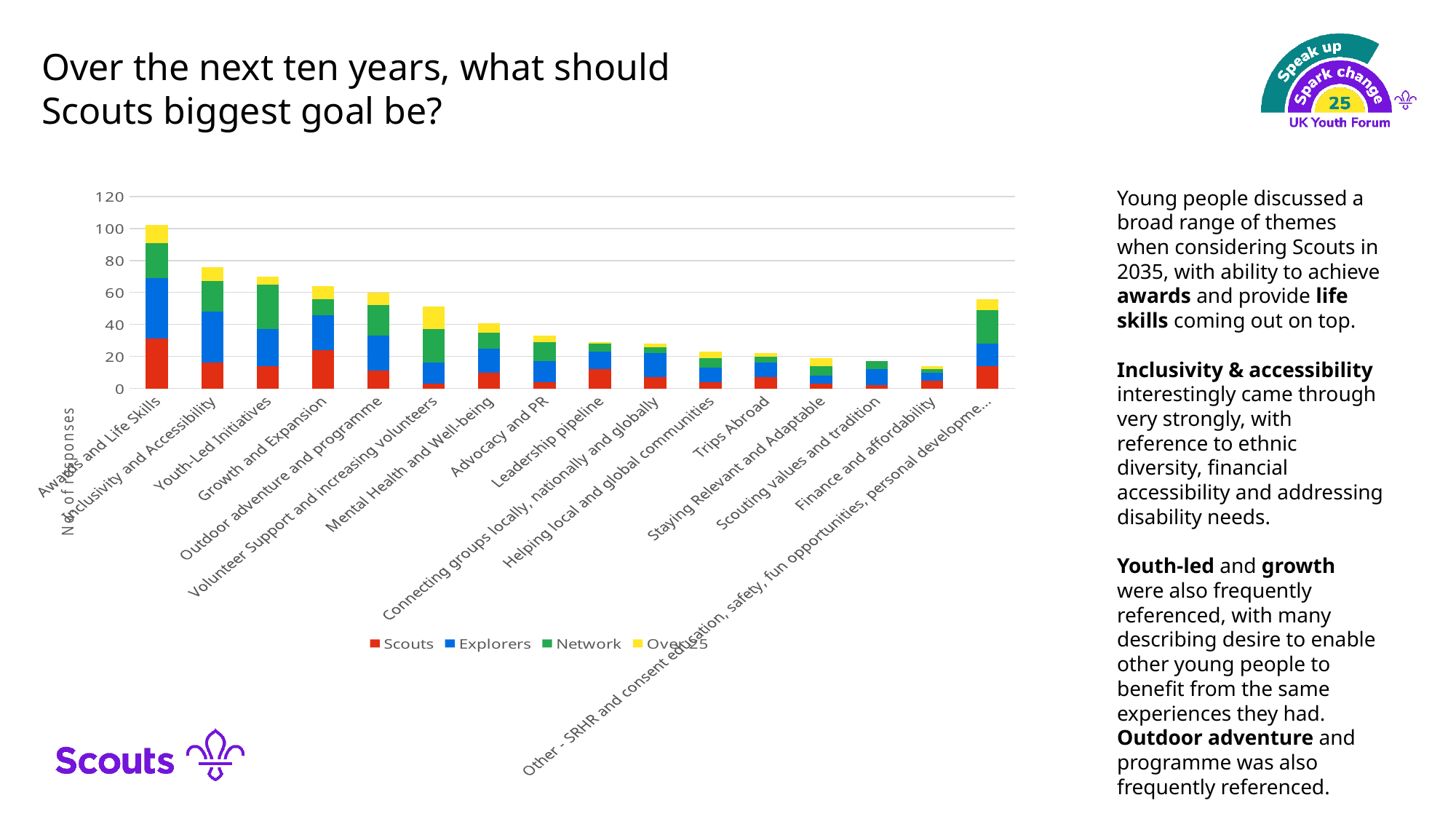
Which has the larger total: Mental Health and Well-being or Advocacy and PR? Mental Health and Well-being What kind of chart is shown on the slide? Stacked bar chart Is the total for Inclusivity and Accessibility greater or less than 60? greater Which has the larger total: Youth-Led Initiatives or Growth and Expansion? Youth-Led Initiatives Is the total for Awards and Life Skills greater or less than 80? greater Which series are listed in the chart legend? Scouts, Explorers, Network, Over 25 How many series does the chart legend list? 4 Which category has the highest total number of responses? Awards and Life Skills How many categories are plotted along the x axis of the chart? 16 Which colour represents the Explorers series in the chart? Blue Is the total for Trips Abroad greater or less than 40? less